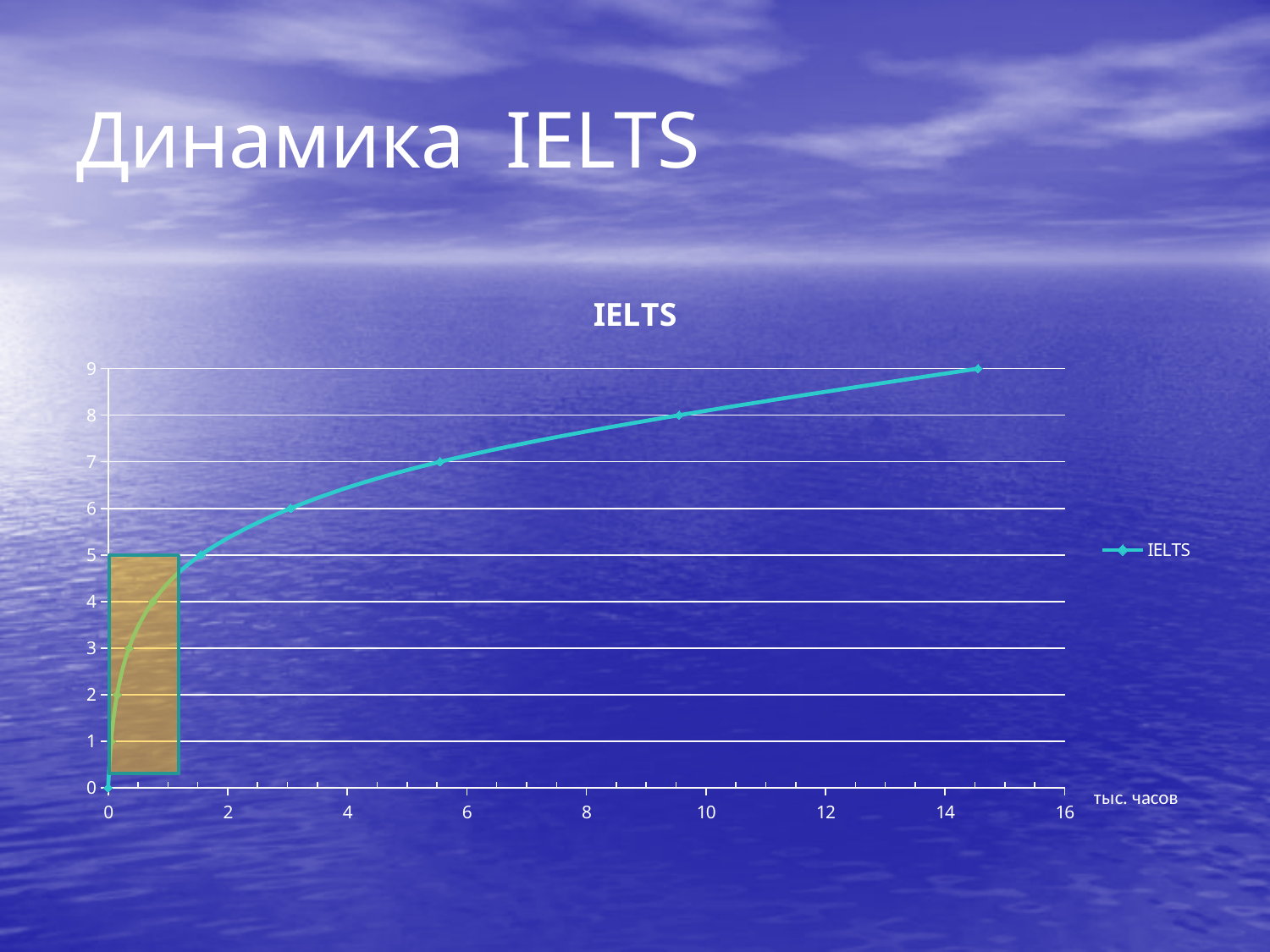
What kind of chart is shown on the slide? line chart What is the label on the x axis of the chart? тыс. часов Do the values of the IELTS line rise or fall as the x axis increases? rise What is the lowest value on the IELTS line? 0 What is the highest value reached by the IELTS line? 9 What is the value of the rightmost point on the IELTS line? 9 Is the value of the IELTS line at 12 thousand hours greater or less than 8? greater What is the name of the series shown in the legend? IELTS How many series does the legend list? 1 Is the value of the IELTS line at 4 thousand hours greater or less than 5? greater Is the value of the IELTS line at 2 thousand hours greater or less than 7? less